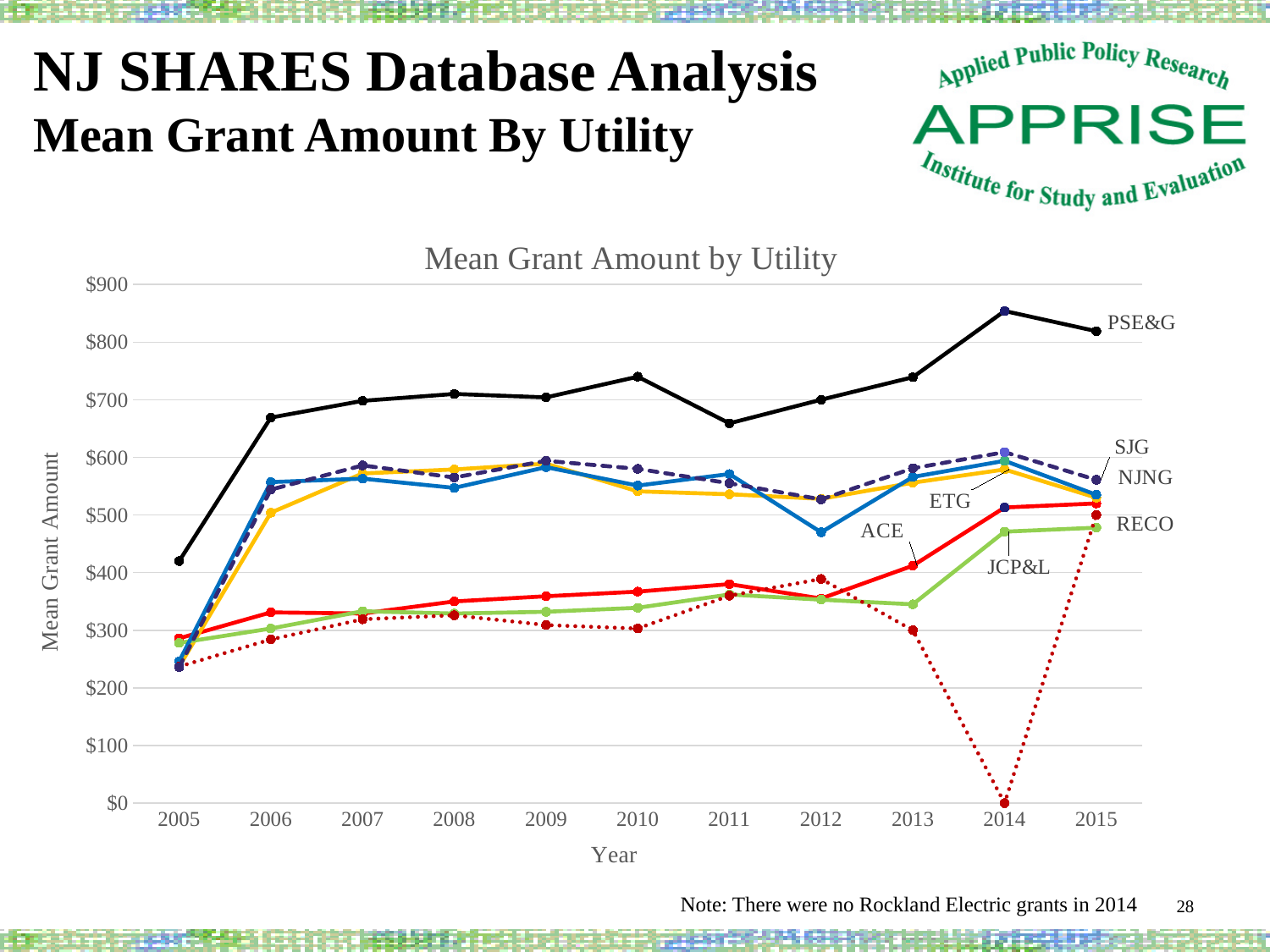
Is the mean grant amount for PSE&G in 2005 greater or less than $500? less What kind of chart is shown on the slide? line chart Is the mean grant amount for PSE&G in 2014 greater or less than $800? greater Which utility has the highest mean grant amount in 2014? PSE&G Is the mean grant amount for RECO in 2013 greater or less than $400? less How many years are plotted along the x axis of the chart? 11 Does the mean grant amount for PSE&G rise or fall from 2011 to 2014? rise Which utility has the lowest mean grant amount in 2014? RECO What is the mean grant amount for RECO in 2014? $0 How many utilities are labelled as series on the chart? 7 Which is larger in 2010, the mean grant amount for PSE&G or for JCP&L? PSE&G What is the title of the chart? Mean Grant Amount by Utility